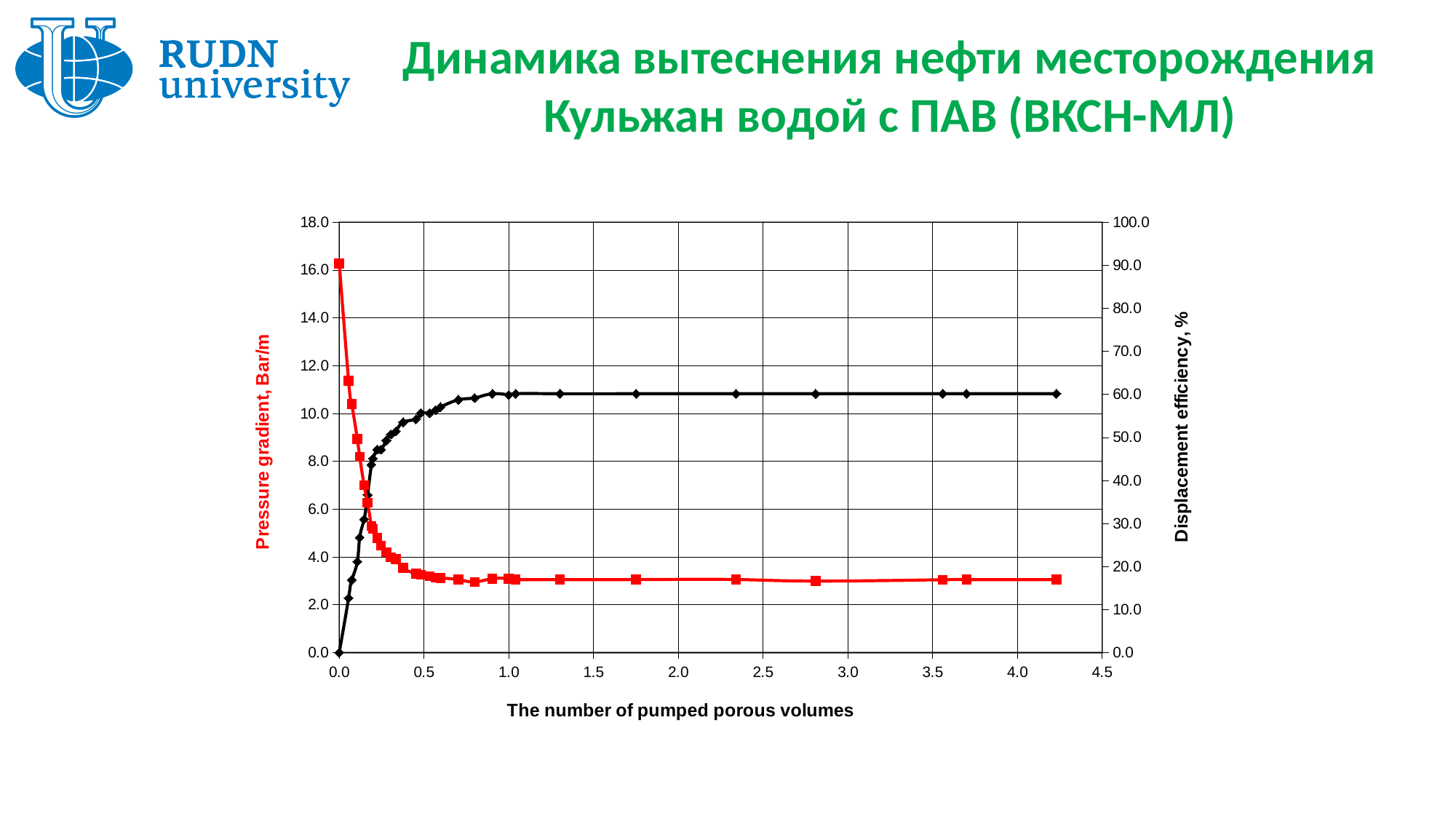
Is the pressure gradient at 0.0 pumped porous volumes greater or less than 14.0 Bar/m? greater Is the displacement efficiency at 2.0 pumped porous volumes greater or less than 50.0%? greater Is the pressure gradient at about 4.2 pumped porous volumes greater or less than 4.0 Bar/m? less How many data series are plotted on the chart? 2 What is the title of the x axis? The number of pumped porous volumes What is the displacement efficiency at 0.0 pumped porous volumes? 0.0 Does the pressure gradient (red line) rise or fall as the number of pumped porous volumes increases? fall What kind of chart is shown on the slide? line chart What is the title of the right-hand y axis? Displacement efficiency, % Does the displacement efficiency (black line) rise or fall as the number of pumped porous volumes increases from 0.0 to 1.0? rise